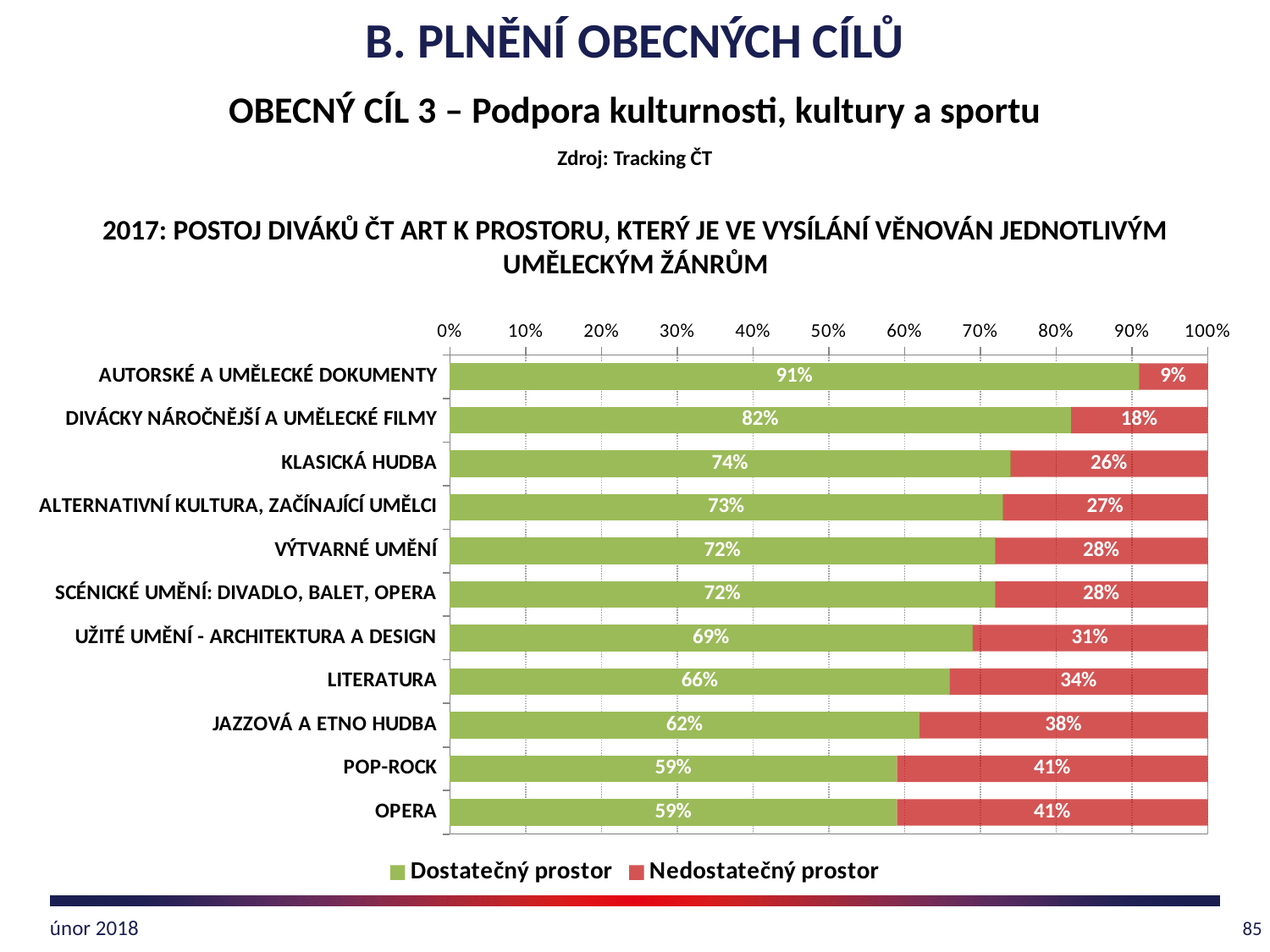
What is the value of "Nedostatečný prostor" for AUTORSKÉ A UMĚLECKÉ DOKUMENTY? 9% Which has a larger "Nedostatečný prostor" value, POP-ROCK or LITERATURA? POP-ROCK Which colour represents "Nedostatečný prostor" in the chart? Red Which category has the lowest value for "Nedostatečný prostor"? AUTORSKÉ A UMĚLECKÉ DOKUMENTY What is the value of "Nedostatečný prostor" for LITERATURA? 34% How many series does the legend list? 2 What kind of chart is shown on the slide? Stacked bar chart What is the difference between the "Dostatečný prostor" values for DIVÁCKY NÁROČNĚJŠÍ A UMĚLECKÉ FILMY and JAZZOVÁ A ETNO HUDBA? 20% Which category has the highest value for "Dostatečný prostor"? AUTORSKÉ A UMĚLECKÉ DOKUMENTY What is the value of "Dostatečný prostor" for KLASICKÁ HUDBA? 74% How many categories are shown on the chart? 11 What is the total of the stacked bar for OPERA? 100%